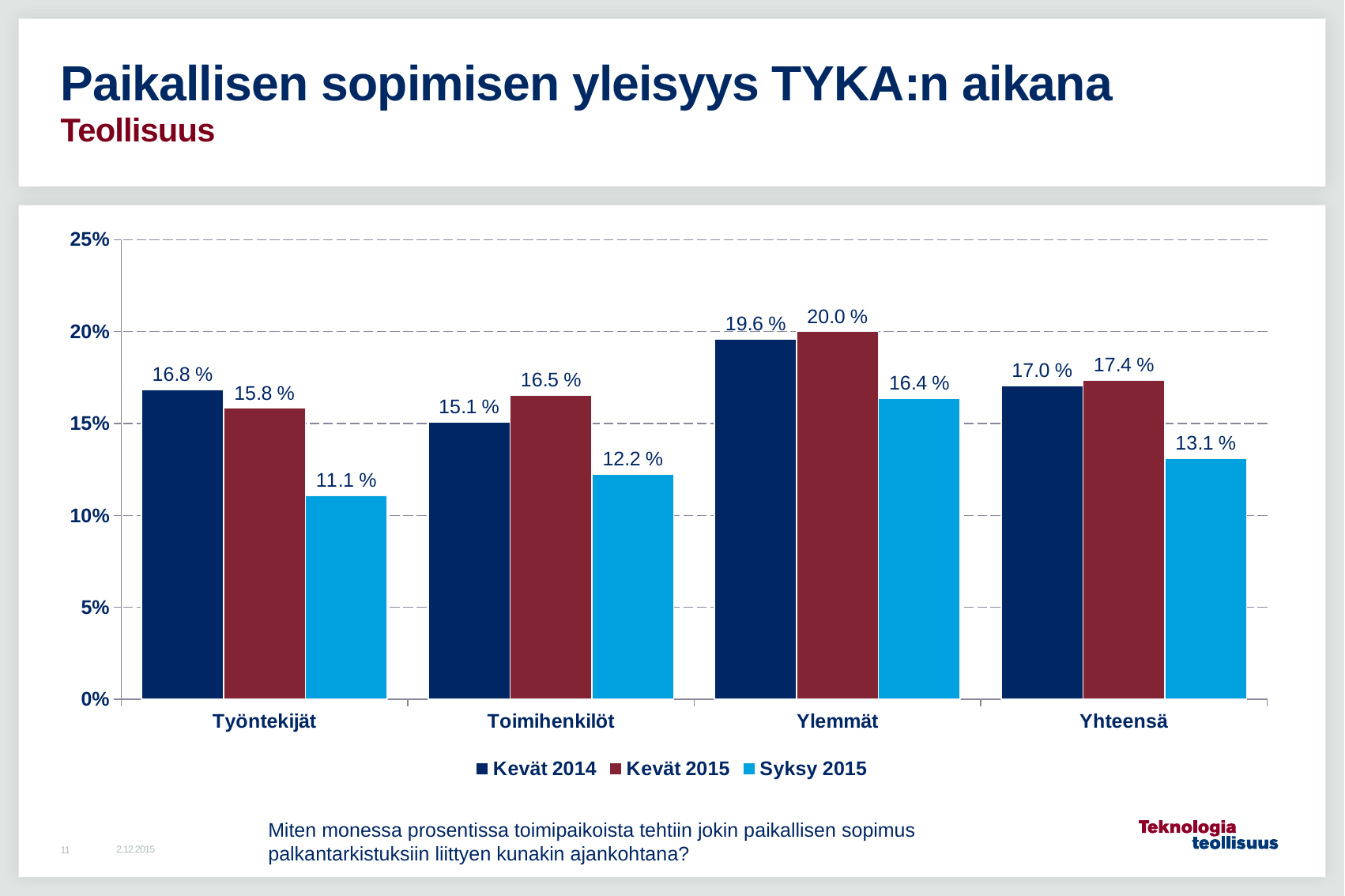
What is the value for Ylemmät in the Syksy 2015 series? 16.4 % What is the subtitle shown under the main title of the slide? Teollisuus What is the value for Yhteensä in the Kevät 2015 series? 17.4 % Which category has the highest value in the Kevät 2015 series? Ylemmät What is the value for Työntekijät in the Kevät 2014 series? 16.8 % Is the Syksy 2015 value for Yhteensä greater or less than 15%? less What kind of chart is shown on the slide? bar chart How many categories are shown on the x axis? 4 What is the difference between the Kevät 2015 and Syksy 2015 values for Toimihenkilöt? 4.3 % Which is larger for Työntekijät: the Kevät 2014 value or the Kevät 2015 value? Kevät 2014 Which category has the lowest value in the Syksy 2015 series? Työntekijät How many series does the legend list? 3